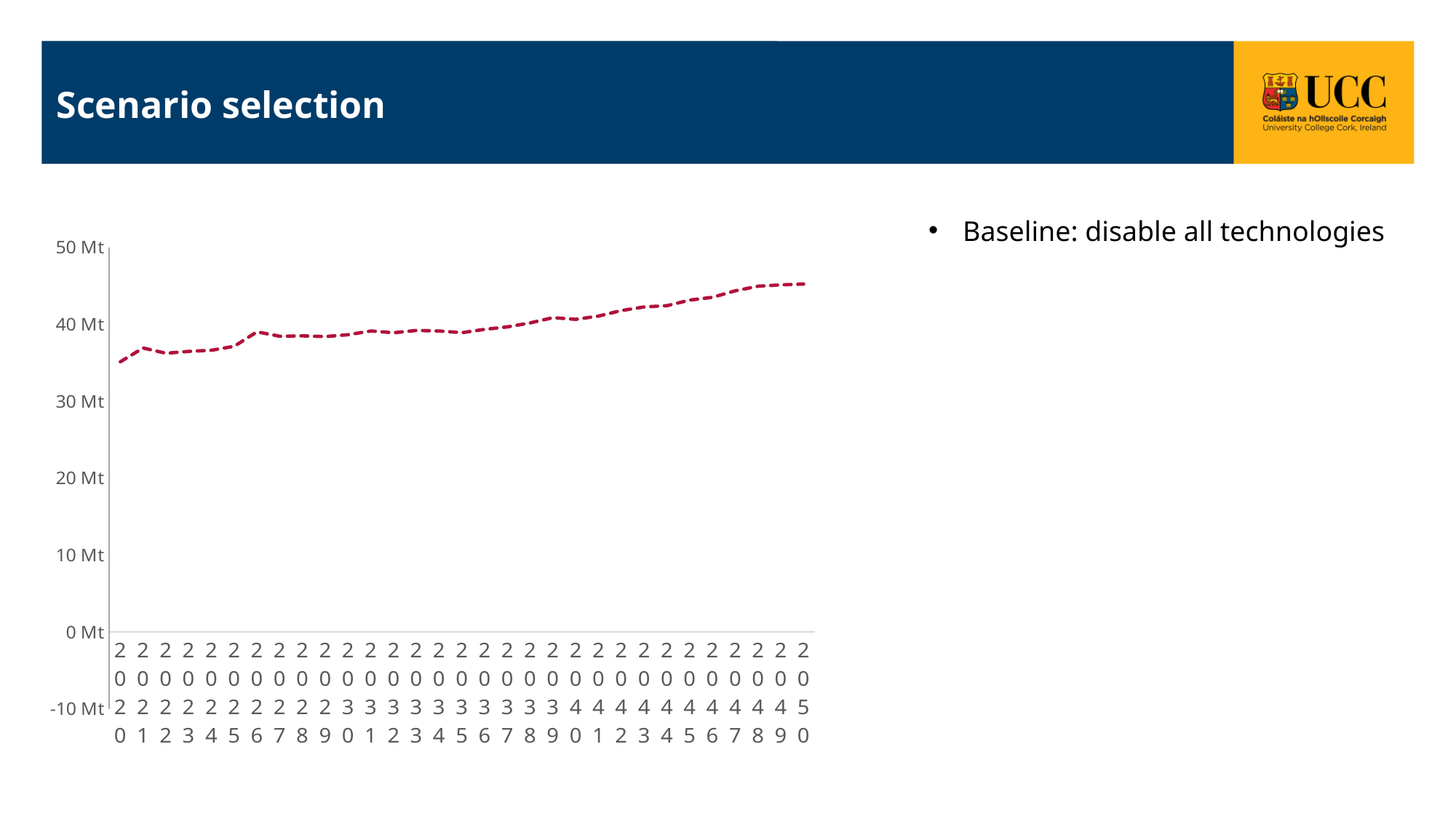
How many years are plotted along the x axis of the chart? 31 Is the value for 2050 greater or less than 50 Mt? less What is the first year shown on the x axis of the chart? 2020 What kind of chart is shown on the slide? line chart Which year has the lowest value on the chart? 2020 Is the value for 2050 greater or less than 40 Mt? greater Is the value for 2020 greater or less than 30 Mt? greater Do the values on the chart generally rise or fall from 2020 to 2050? rise Which year has the highest value on the chart? 2050 What unit is shown on the y axis of the chart? Mt Which is larger, the value for 2050 or the value for 2020? 2050